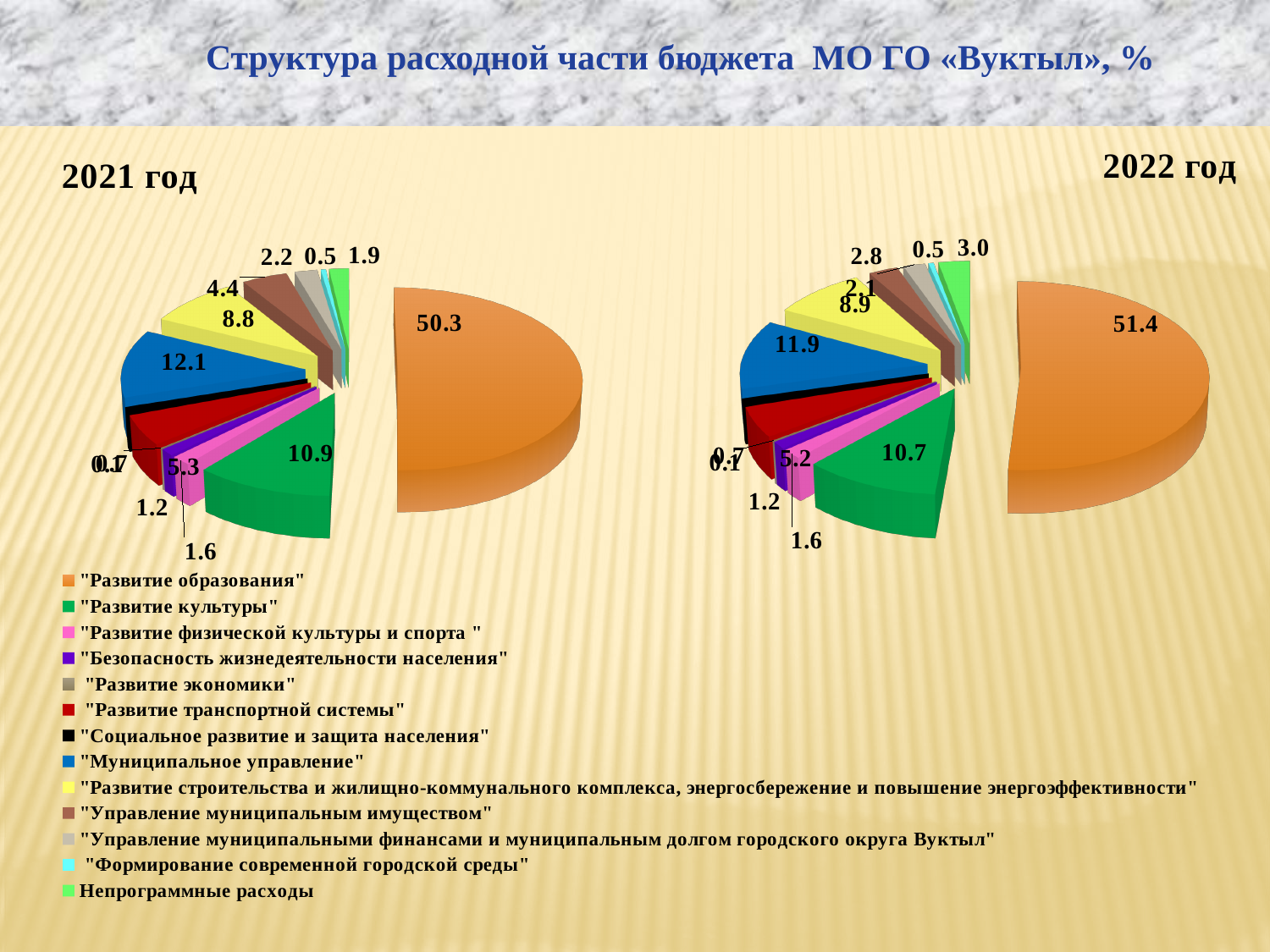
In the 2021 год chart, which category has the largest share? "Развитие образования" What kind of charts are shown on the slide? Pie charts In the 2022 год chart, what is the value for "Непрограммные расходы"? 3.0 How many categories does the legend list? 13 Is the value for "Муниципальное управление" larger in the 2021 год chart or the 2022 год chart? 2021 год In the 2022 год chart, what is the value for "Развитие культуры"? 10.7 What is the title of the slide? Структура расходной части бюджета МО ГО «Вуктыл», % In the 2021 год chart, what is the value for "Развитие образования"? 50.3 In the 2022 год chart, what is the value for "Развитие образования"? 51.4 In the 2021 год chart, what is the value for "Развитие строительства и жилищно-коммунального комплекса, энергосбережение и повышение энергоэффективности"? 8.8 In the 2021 год chart, what is the value for "Муниципальное управление"? 12.1 By how much did the share of "Развитие образования" change from the 2021 год chart to the 2022 год chart? 1.1